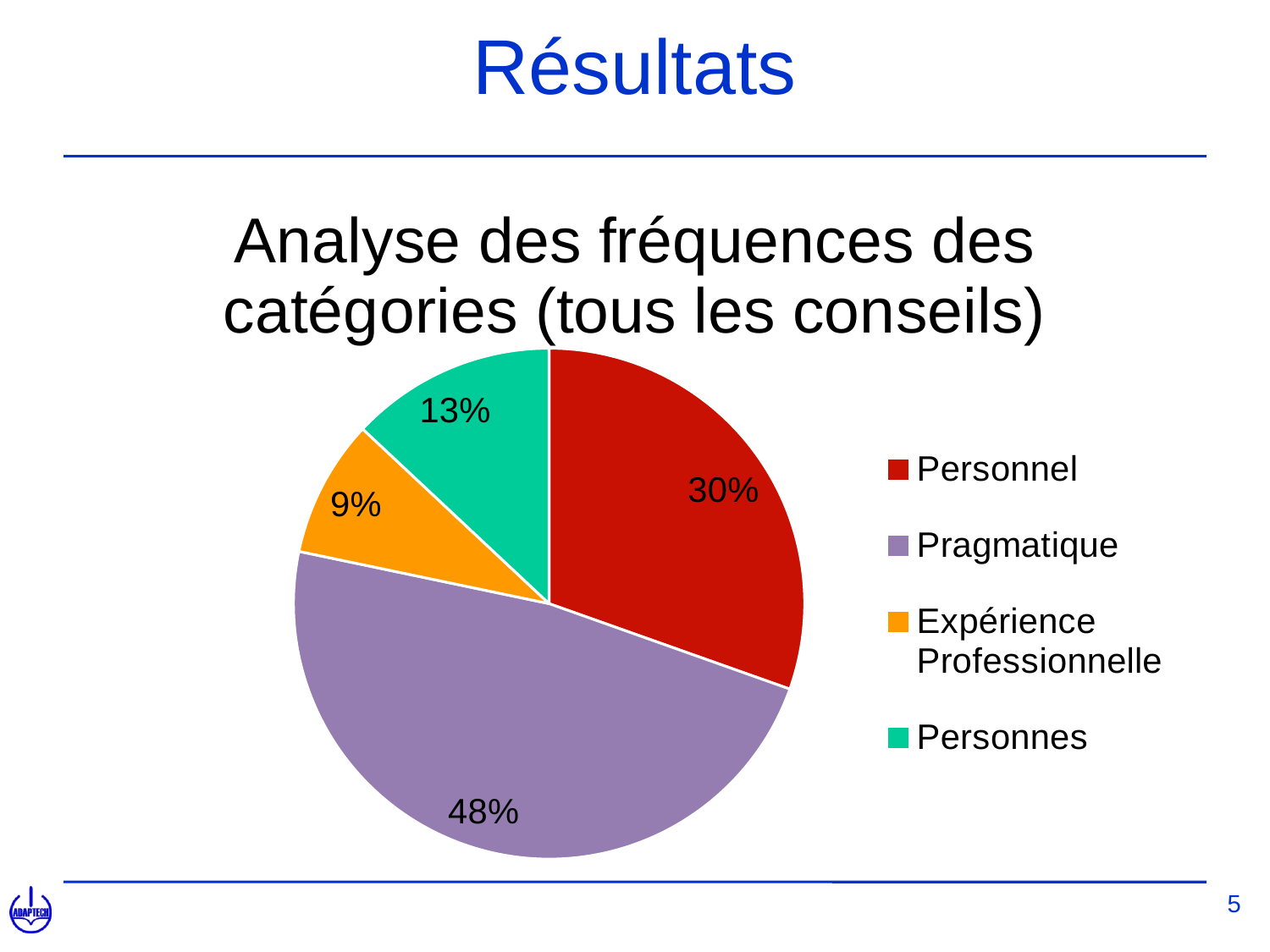
What colour is the slice for Personnes? green What share of the pie does Pragmatique represent? 48% What is the difference in percentage points between Pragmatique and Personnel? 18 What is the title of the chart? Analyse des fréquences des catégories (tous les conseils) Which category has the smallest slice of the pie? Expérience Professionnelle Which is larger, the share for Personnes or the share for Expérience Professionnelle? Personnes How many categories does the pie chart show? 4 What share of the pie does Personnes represent? 13% What share of the pie does Personnel represent? 30% Which category has the largest slice of the pie? Pragmatique What type of chart is shown on the slide? pie chart